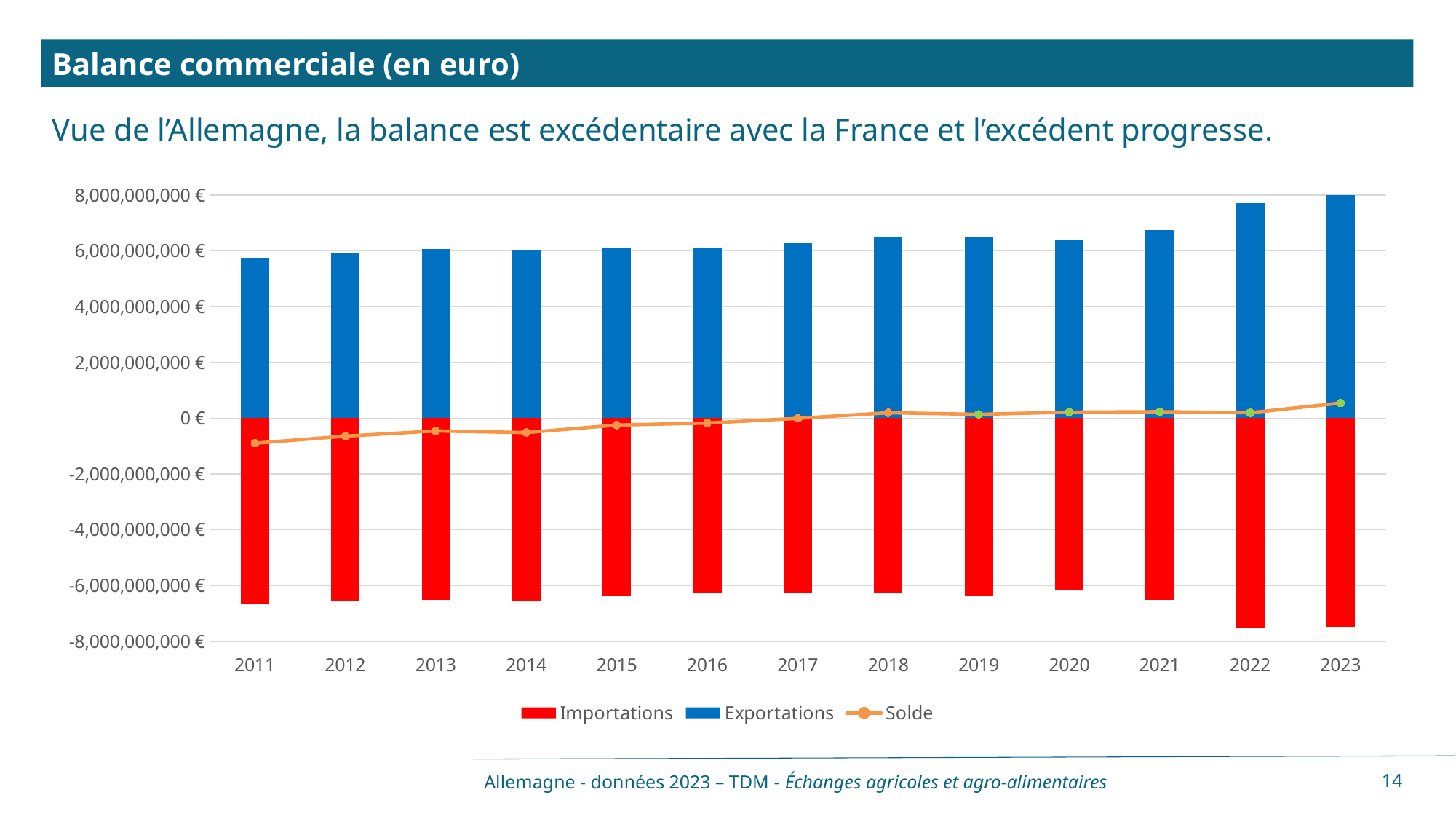
How many years are shown on the x axis of the chart? 13 Does the Solde line rise or fall overall from 2011 to 2023? rise Which year has the highest Exportations value? 2023 What kind of chart is shown on the slide? bar chart with a line Which colour represents Importations in the chart? red Is the Solde value for 2011 greater or less than 0 €? less Is the Solde value for 2023 greater or less than 0 €? greater Which is larger, the Exportations value for 2022 or for 2013? 2022 How many series does the legend list? 3 Is the Exportations value for 2023 greater or less than 6,000,000,000 €? greater Which year has the lowest Exportations value? 2011